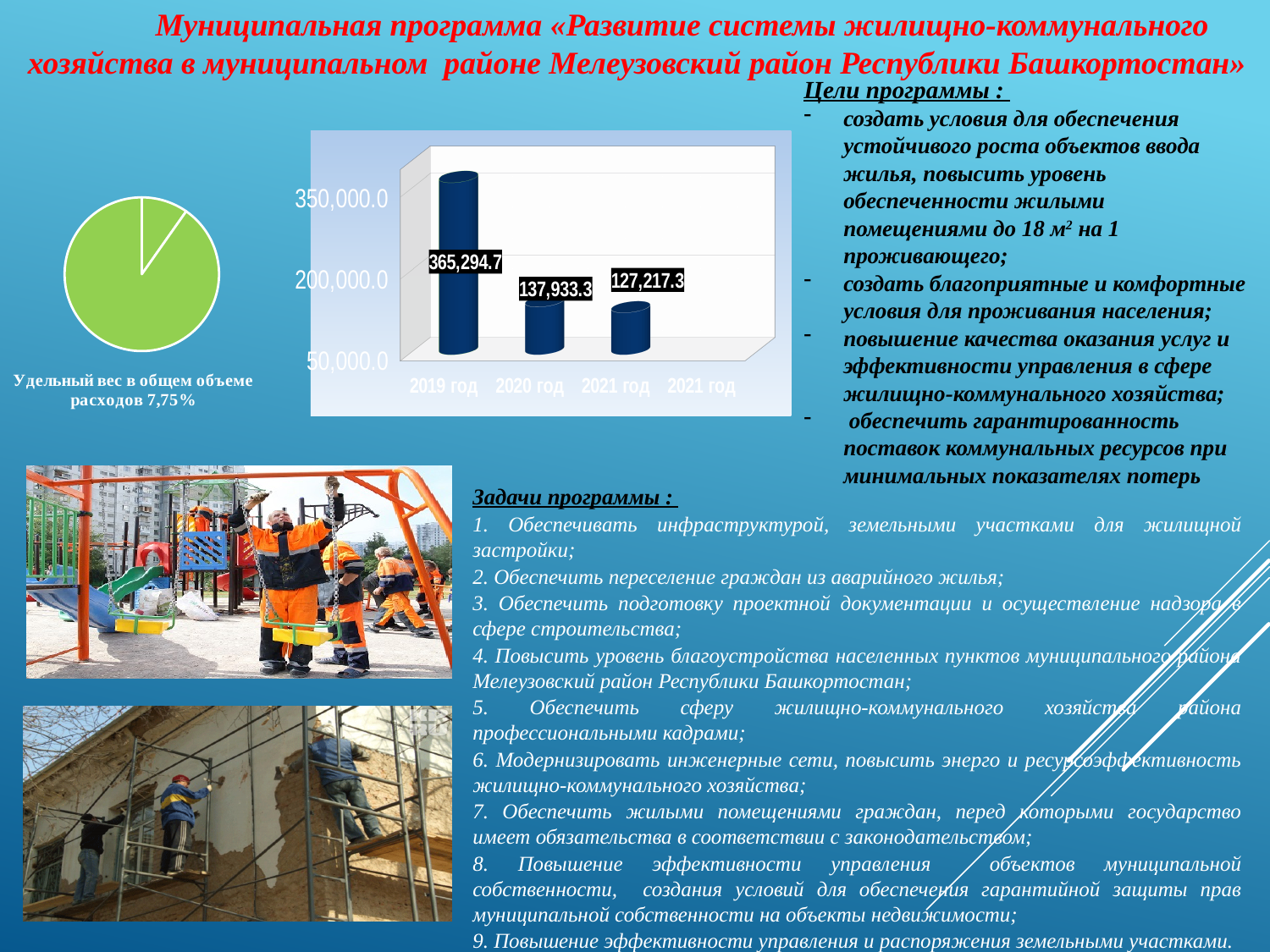
According to the pie chart caption, what share of total expenditures does the program represent (Удельный вес в общем объеме расходов)? 7,75% In the bar chart, is the value for 2020 год greater or less than 200,000.0? less How many bars are plotted in the bar chart? 3 In the bar chart, which year has the highest value? 2019 год In the bar chart, what is the value for 2019 год? 365,294.7 In the bar chart, do the values rise or fall from the first bar to the last bar? Fall In the bar chart, what is the value for 2020 год? 137,933.3 In the bar chart, what is the value of the third (rightmost) bar? 127,217.3 In the bar chart, which is larger: the value for 2019 год or the value for 2020 год? 2019 год In the bar chart, which bar has the lowest value? The third bar (127,217.3) In the bar chart, what is the difference between the values for 2019 год and 2020 год? 227,361.4 What type of chart is shown in the middle of the slide with the year labels? Bar chart